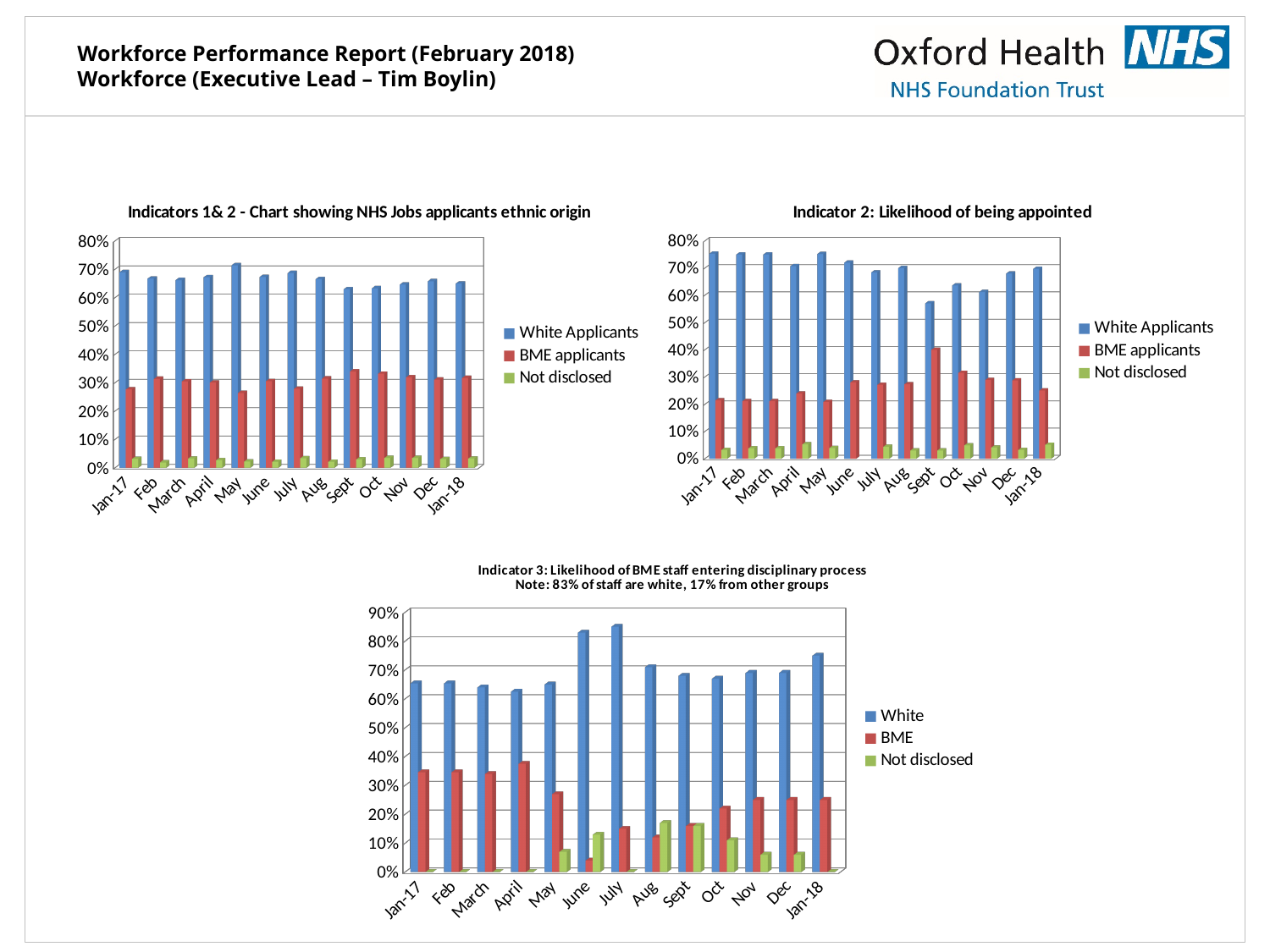
In the chart 'Indicator 2: Likelihood of being appointed', is the value for White Applicants in Sept greater or less than 60%? less What kind of chart is 'Indicator 3: Likelihood of BME staff entering disciplinary process'? Bar chart What are the three legend entries in the chart 'Indicator 3: Likelihood of BME staff entering disciplinary process'? White, BME, Not disclosed In the chart 'Indicator 3: Likelihood of BME staff entering disciplinary process', is the value for White in July greater or less than 80%? greater In the chart 'Indicators 1& 2 - Chart showing NHS Jobs applicants ethnic origin', is the value for White Applicants in May greater or less than 70%? greater In the chart 'Indicator 2: Likelihood of being appointed', how many series does the legend list? 3 In the chart 'Indicators 1& 2 - Chart showing NHS Jobs applicants ethnic origin', how many months are shown on the x axis? 13 In the chart 'Indicator 3: Likelihood of BME staff entering disciplinary process', which is larger in June: White or BME? White In the chart 'Indicator 3: Likelihood of BME staff entering disciplinary process', which month has the lowest value for BME? June In the chart 'Indicator 2: Likelihood of being appointed', which month has the highest value for BME applicants? Sept In the chart 'Indicators 1& 2 - Chart showing NHS Jobs applicants ethnic origin', which month has the lowest value for BME applicants? May In the chart 'Indicator 2: Likelihood of being appointed', which month has the lowest value for White Applicants? Sept